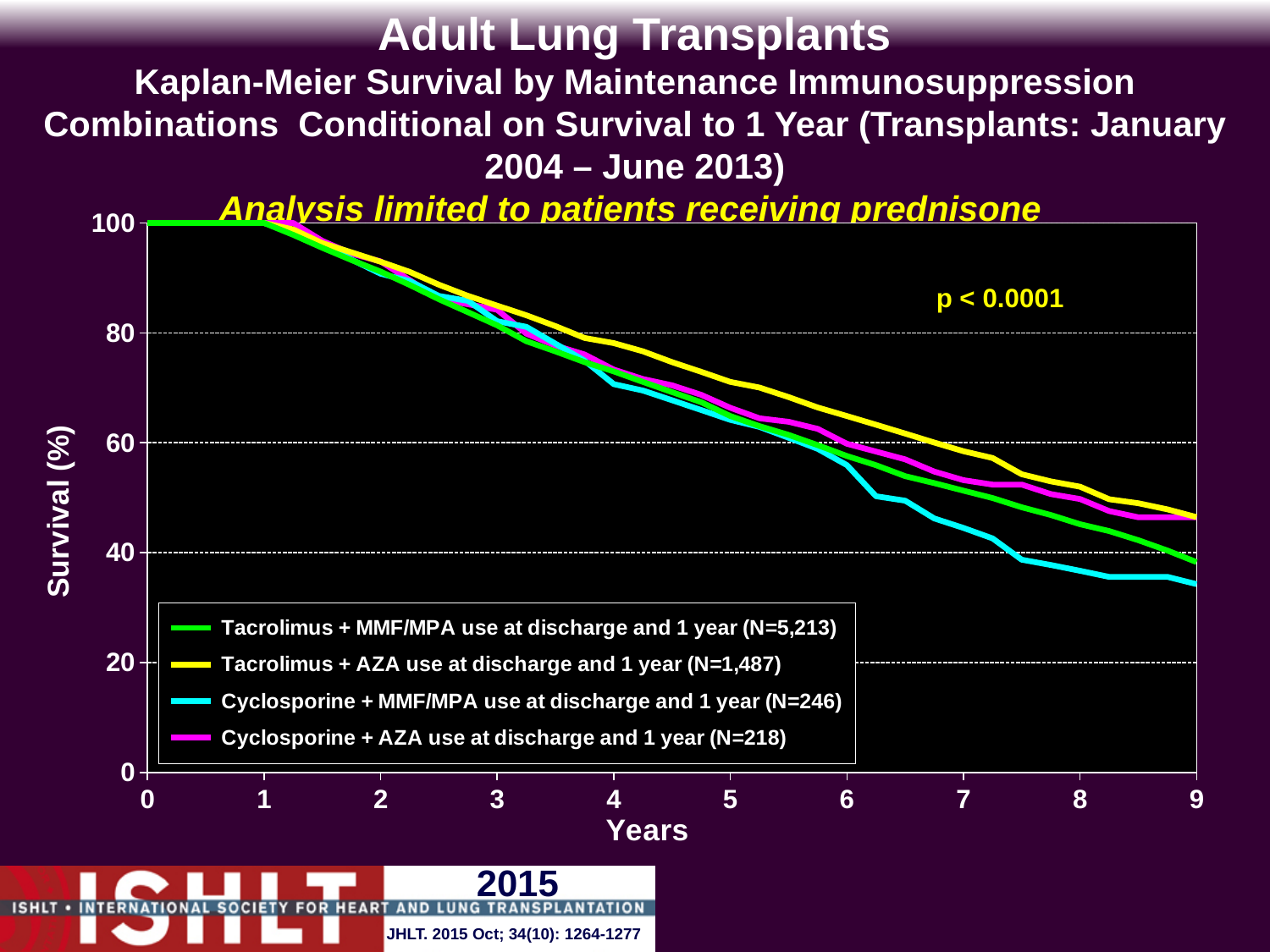
What is the N for the Tacrolimus + MMF/MPA use at discharge and 1 year series in the legend? N=5,213 Is the survival for Cyclosporine + MMF/MPA use at discharge and 1 year at year 9 greater or less than 40? less Which series has the lowest survival at year 9? Cyclosporine + MMF/MPA use at discharge and 1 year (N=246) Is the survival for Tacrolimus + AZA use at discharge and 1 year at year 9 greater or less than 40? greater What is the survival (%) for Tacrolimus + AZA use at discharge and 1 year at year 1? 100 At year 8, which has higher survival: Tacrolimus + MMF/MPA or Cyclosporine + MMF/MPA? Tacrolimus + MMF/MPA Is the survival for Tacrolimus + MMF/MPA use at discharge and 1 year at year 5 greater or less than 60? greater What kind of chart is shown on the slide? line chart Do the survival curves rise or fall as years increase? fall How many series does the legend list? 4 Which series has the highest survival at year 7? Tacrolimus + AZA use at discharge and 1 year (N=1,487) What p-value is printed on the chart? p < 0.0001